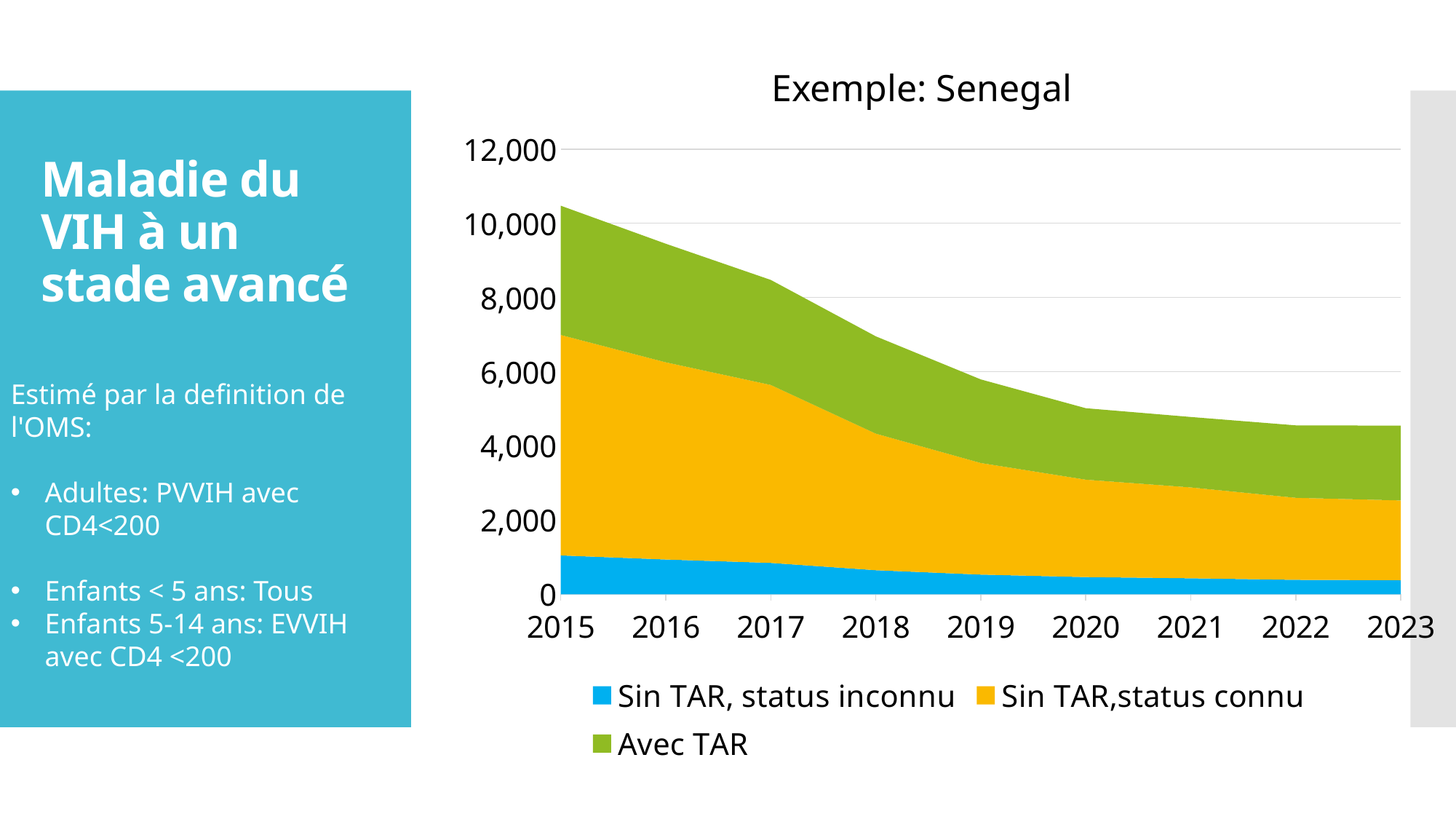
Which year has the highest total stacked value? 2015 Is the total stacked value in 2015 greater or less than 10,000? greater What is the title of the chart? Exemple: Senegal Is the total stacked value in 2019 greater or less than 8,000? less How many series does the chart's legend list? 3 Is the total stacked value larger in 2016 or in 2021? 2016 What kind of chart is shown on the slide? Stacked area chart Does the total stacked value rise or fall from 2015 to 2023? Fall Which series is shown in green in the chart? Avec TAR Is the total stacked value in 2023 greater or less than 6,000? less How many years are shown along the x axis of the chart? 9